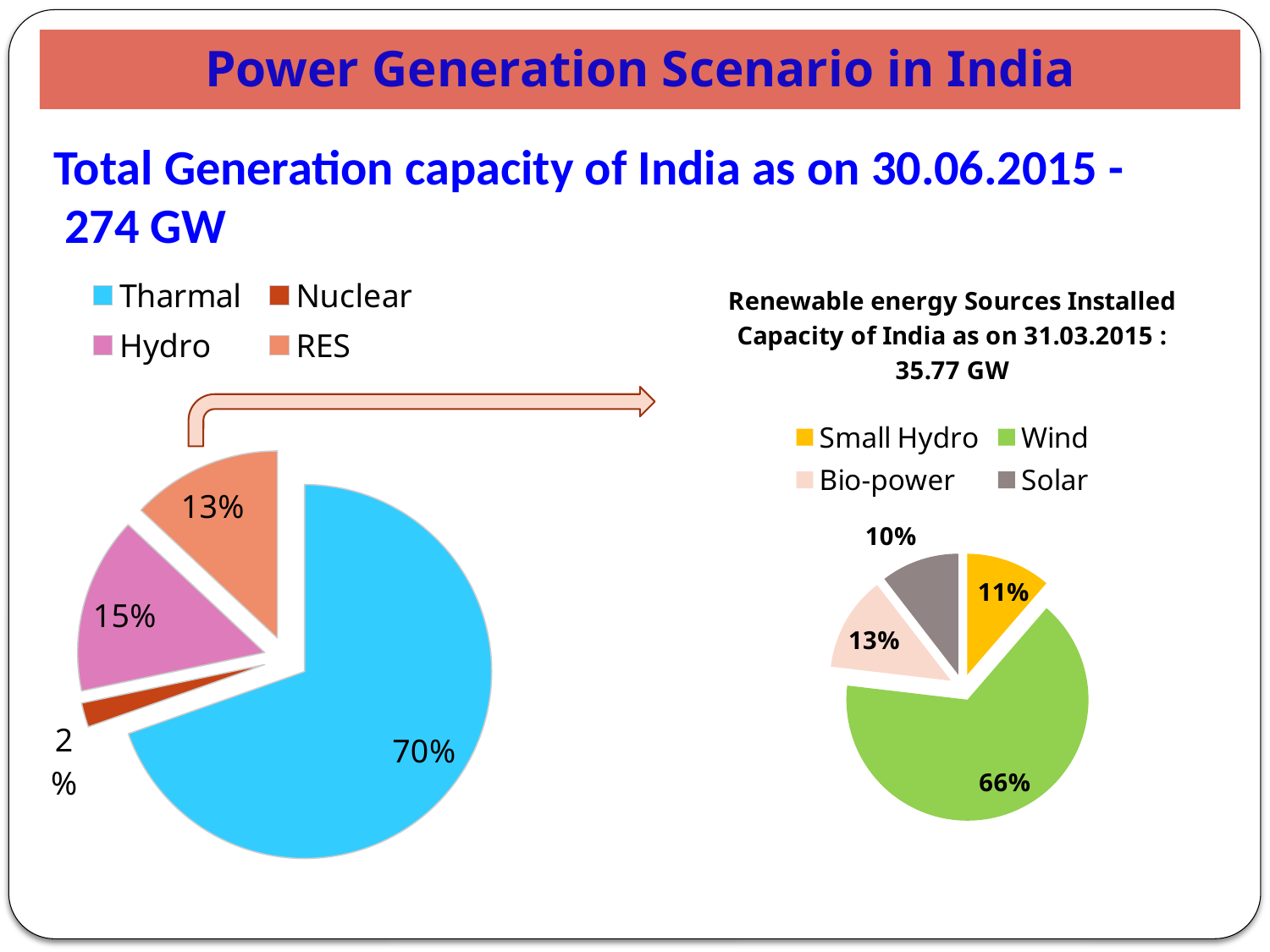
In the left pie chart (total generation capacity), what share does Tharmal have? 70% In the left pie chart (total generation capacity), how many categories are shown? 4 What type of chart is used on the right side of the slide for renewable energy sources? Pie chart In the left pie chart (total generation capacity), which category has the smallest share? Nuclear In the right pie chart (Renewable energy Sources Installed Capacity), what share does Wind have? 66% In the left pie chart (total generation capacity), what is the difference between the Hydro and RES shares? 2 percentage points In the left pie chart (total generation capacity), which category has the largest share? Tharmal In the right pie chart (Renewable energy Sources Installed Capacity), which category has the smallest share? Solar In the right pie chart (Renewable energy Sources Installed Capacity), what share does Solar have? 10% In the left pie chart (total generation capacity), what share does Nuclear have? 2% In the right pie chart (Renewable energy Sources Installed Capacity), which is larger, Small Hydro or Bio-power? Bio-power In the left pie chart (total generation capacity), what share does Hydro have? 15%